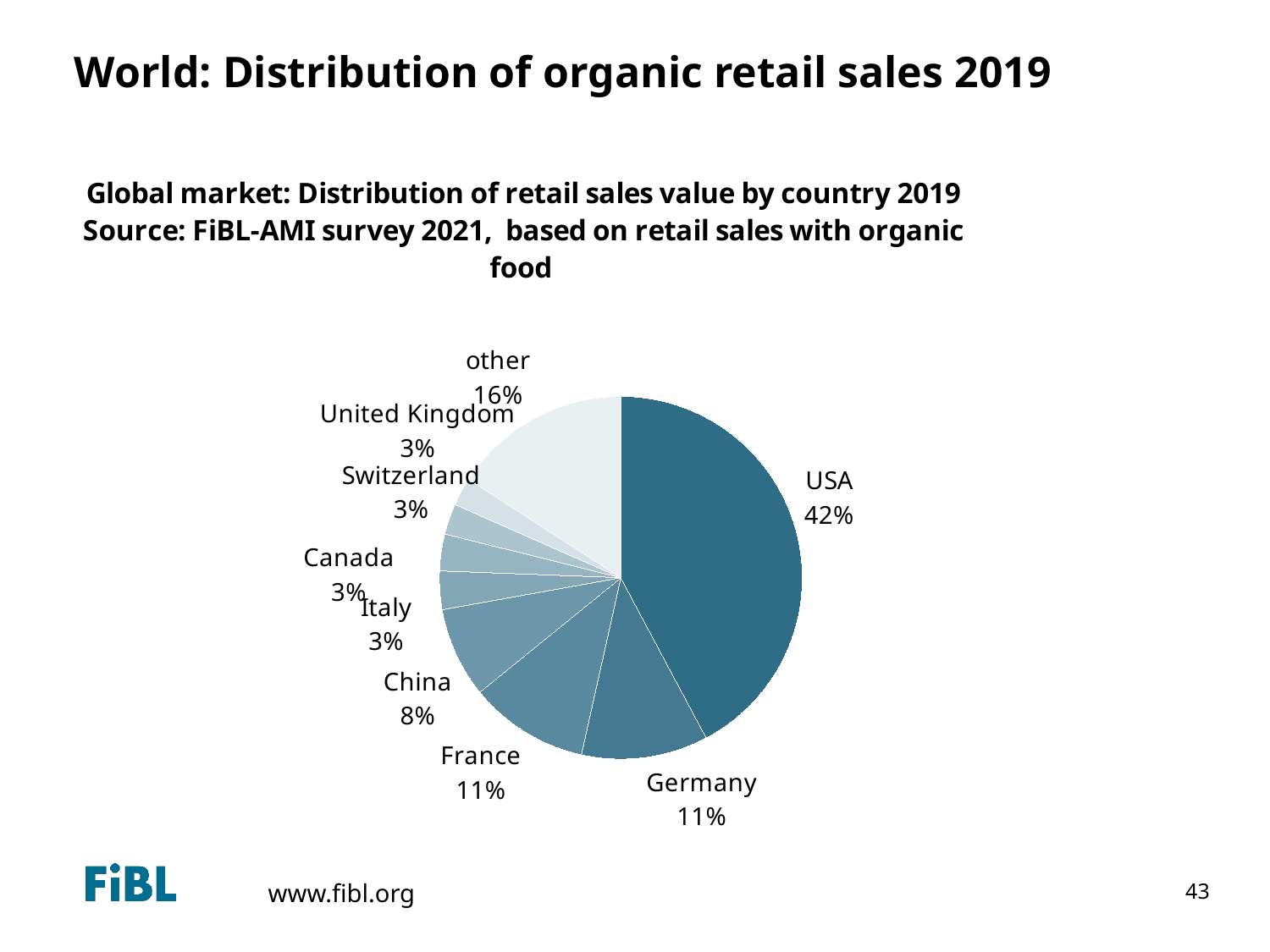
What is the title of the chart? Global market: Distribution of retail sales value by country 2019 Source: FiBL-AMI survey 2021, based on retail sales with organic food What share of organic retail sales does the USA hold? 42% Which country has the largest share of organic retail sales? USA What is the difference in share between the USA and France? 31% What share of organic retail sales does China hold? 8% What share of organic retail sales does Germany hold? 11% What kind of chart is shown on the slide? Pie chart What is the difference in share between China and Italy? 5% What share of organic retail sales is attributed to 'other'? 16% Which has a larger share, China or Canada? China Which has a larger share, 'other' or Germany? other How many slices does the pie chart have? 9